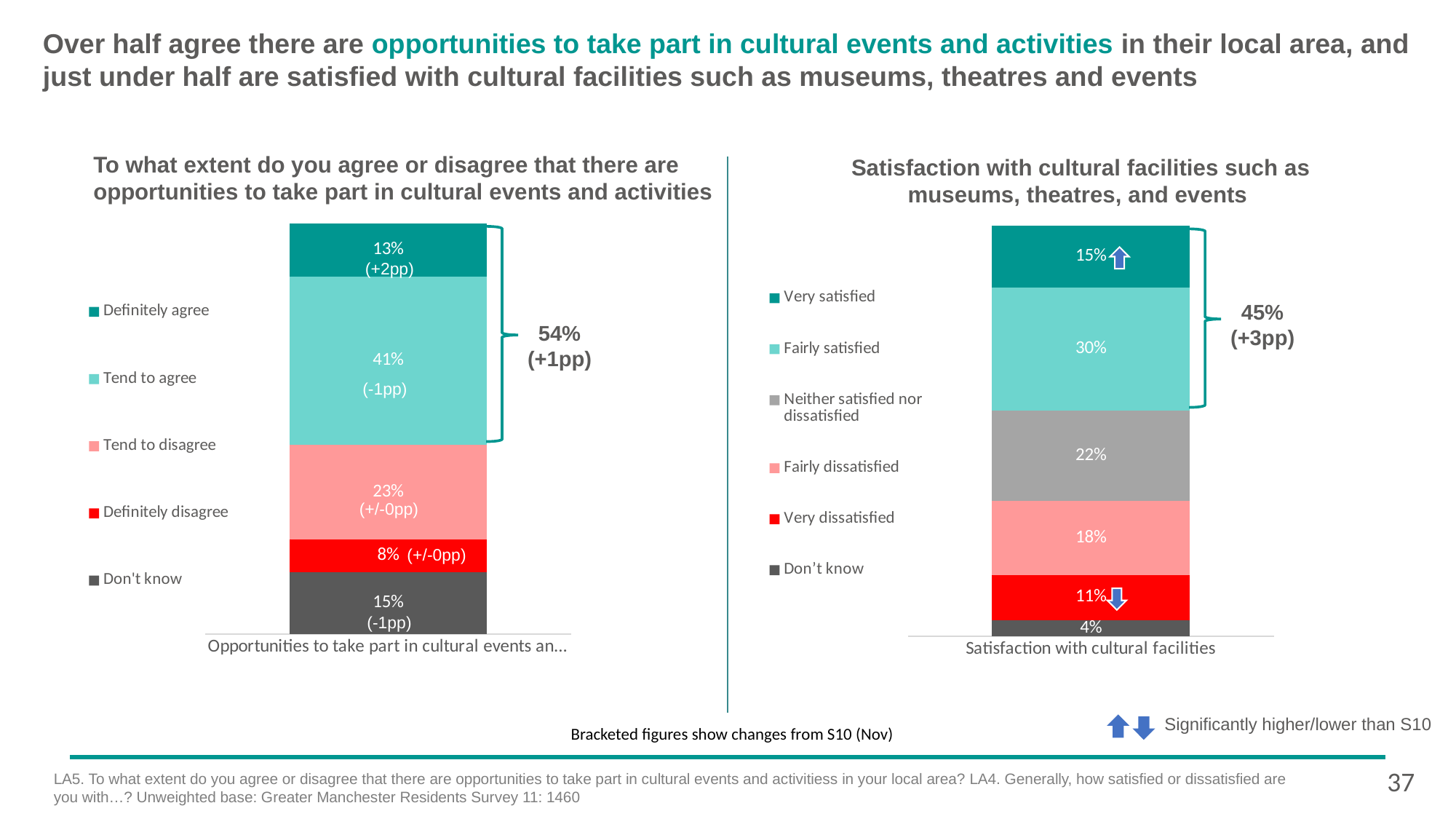
In the right chart on satisfaction with cultural facilities, what percentage answered 'Don't know'? 4% In the right chart on satisfaction with cultural facilities, which is larger: 'Very satisfied' or 'Very dissatisfied'? Very satisfied In the right chart on satisfaction with cultural facilities, which response category has the smallest share? Don't know In the right chart on satisfaction with cultural facilities, what is the difference between 'Neither satisfied nor dissatisfied' (22%) and 'Fairly dissatisfied' (18%)? 4 percentage points In the left chart on opportunities to take part in cultural events and activities, what percentage of respondents 'Tend to agree'? 41% In the left chart on opportunities to take part in cultural events and activities, which response category has the smallest share? Definitely disagree In the left chart on opportunities to take part in cultural events and activities, what is the combined percentage for 'Definitely agree' and 'Tend to agree' shown by the bracket? 54% How many response categories does the legend of the right chart on satisfaction with cultural facilities list? 6 In the left chart on opportunities to take part in cultural events and activities, what percentage 'Definitely disagree'? 8% What type of chart is used in the left chart on opportunities to take part in cultural events and activities? Stacked bar chart In the right chart on satisfaction with cultural facilities, what percentage of respondents are 'Fairly satisfied'? 30% In the left chart on opportunities to take part in cultural events and activities, which response category has the largest share? Tend to agree